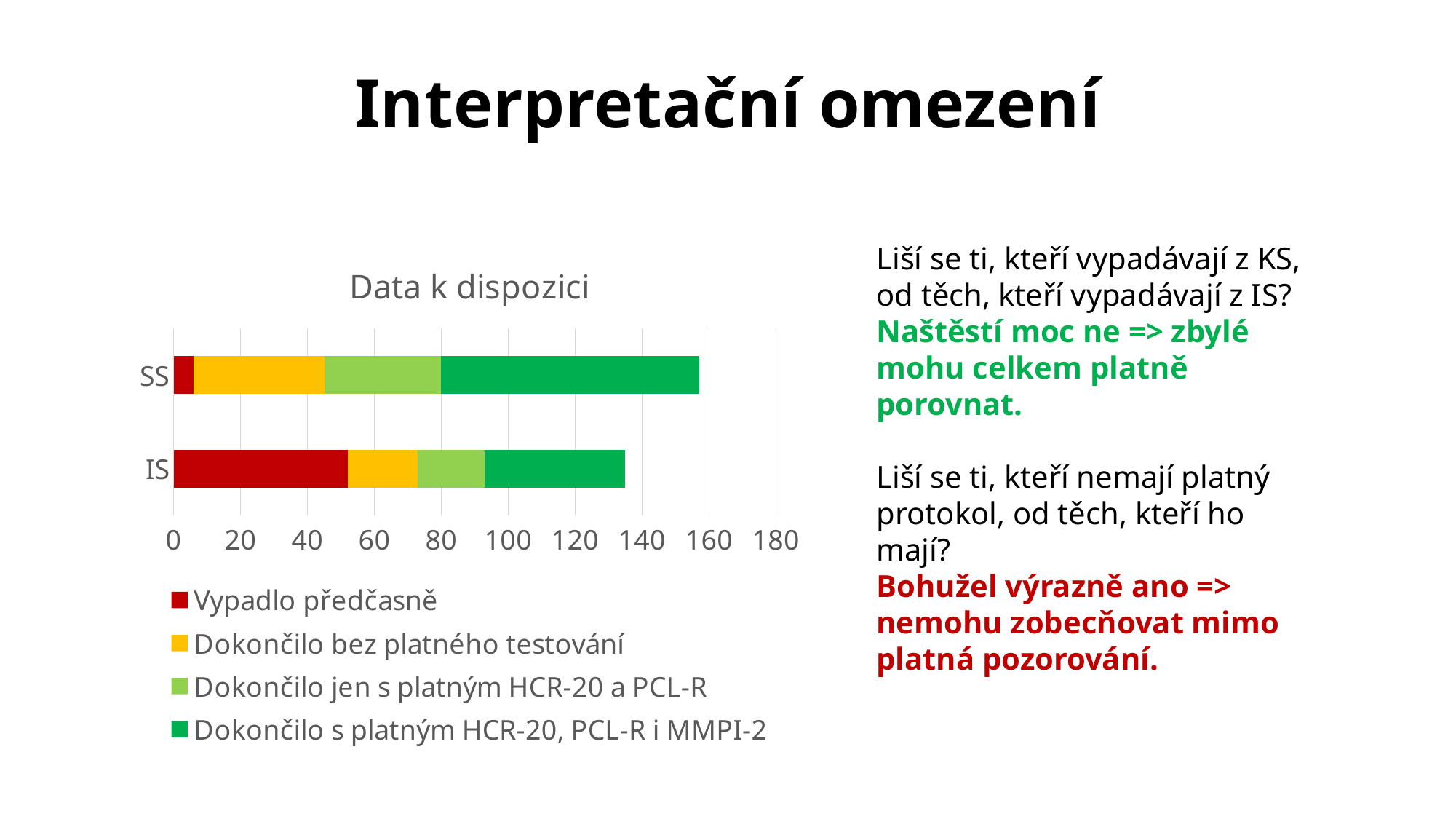
What is the title of the chart? Data k dispozici Is the 'Vypadlo předčasně' value for IS greater or less than 40? greater Is the 'Vypadlo předčasně' value for SS greater or less than 20? less What kind of chart is shown on the slide? Stacked bar chart Which category has the longer total bar, SS or IS? SS Which category has the larger 'Dokončilo s platným HCR-20, PCL-R i MMPI-2' segment, SS or IS? SS Is the total bar length for SS greater or less than 140? greater How many categories are plotted on the chart? 2 How many series does the chart legend list? 4 Which series is shown in dark red in the chart? Vypadlo předčasně Which category has the larger 'Vypadlo předčasně' segment, SS or IS? IS